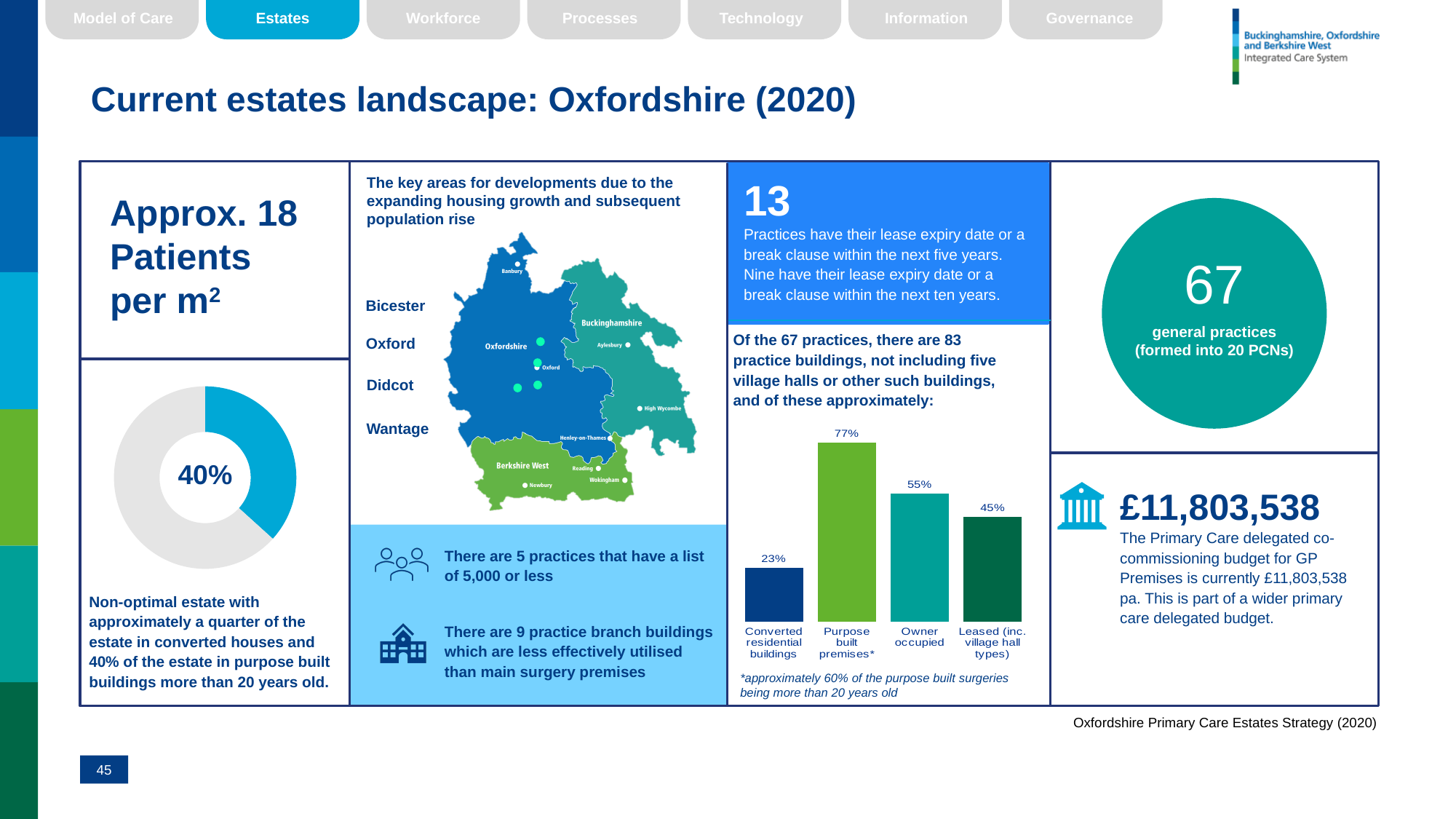
In the bar chart in the middle of the slide, what is the value for Leased (inc. village hall types)? 45% What percentage is shown in the centre of the donut chart on the left of the slide? 40% In the bar chart in the middle of the slide, what is the value for Converted residential buildings? 23% What kind of chart is shown on the left of the slide below 'Approx. 18 Patients per m²'? Donut chart In the bar chart in the middle of the slide, what is the value for Purpose built premises? 77% In the bar chart in the middle of the slide, which category has the lowest value? Converted residential buildings In the bar chart in the middle of the slide, what is the value for Owner occupied? 55% In the bar chart in the middle of the slide, which category has the highest value? Purpose built premises What kind of chart is shown in the middle of the slide below the text about 83 practice buildings? Bar chart In the bar chart in the middle of the slide, which is larger: Owner occupied or Leased (inc. village hall types)? Owner occupied How many categories are shown in the bar chart in the middle of the slide? 4 In the bar chart in the middle of the slide, what is the difference between the Purpose built premises value and the Converted residential buildings value? 54%